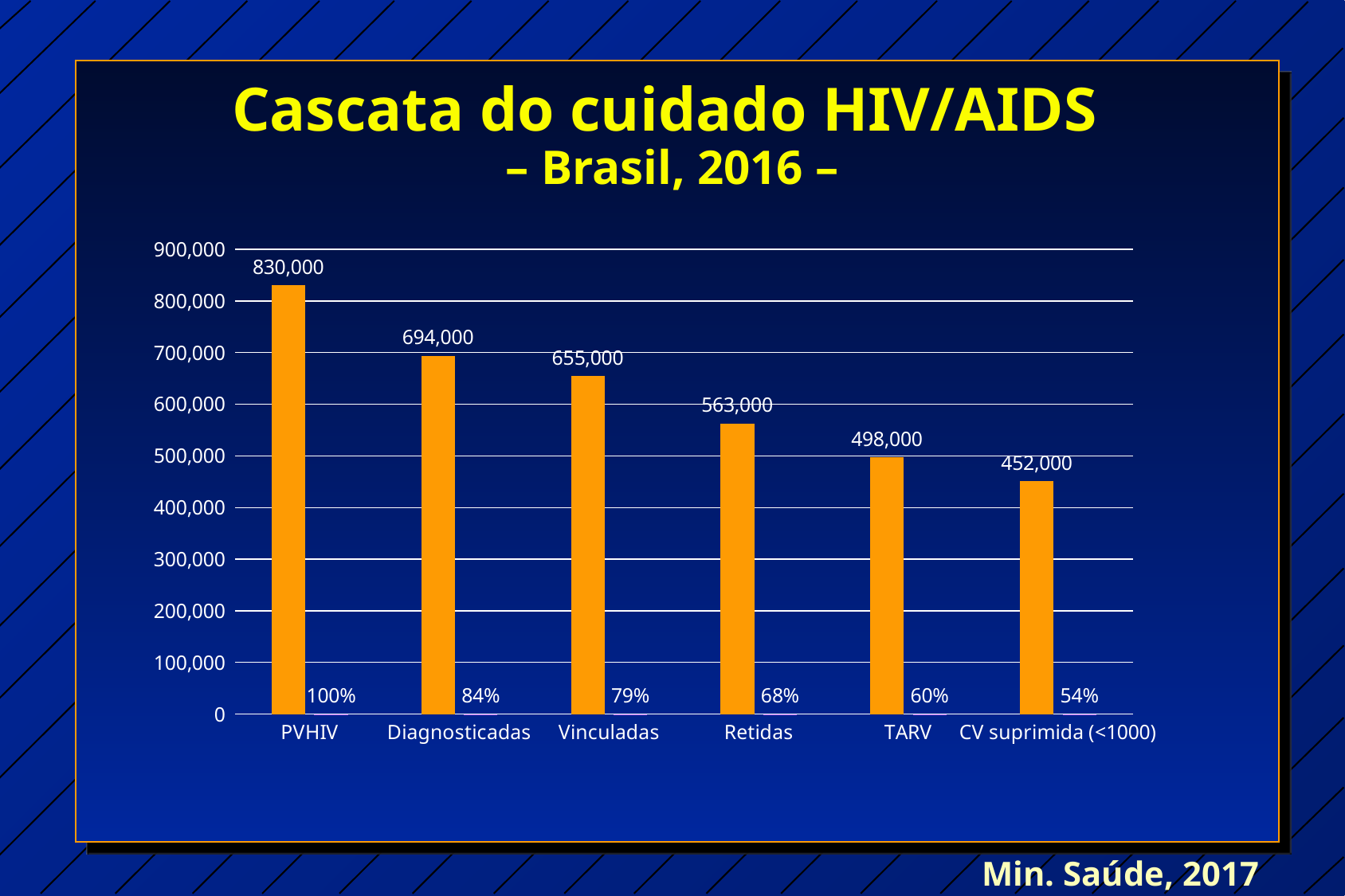
How many categories are shown on the x axis? 6 Which category has the lowest value? CV suprimida (<1000) What is the value for TARV? 498,000 What is the value for PVHIV? 830,000 Do the values rise or fall from left to right along the x axis? Fall What is the value for Diagnosticadas? 694,000 Which is larger, the value for Vinculadas or the value for Retidas? Vinculadas What percentage is shown for CV suprimida (<1000)? 54% What kind of chart is shown on the slide? Bar chart What is the difference between the values for Retidas and TARV? 65,000 What is the difference between the values for PVHIV and Diagnosticadas? 136,000 Which category has the highest value? PVHIV